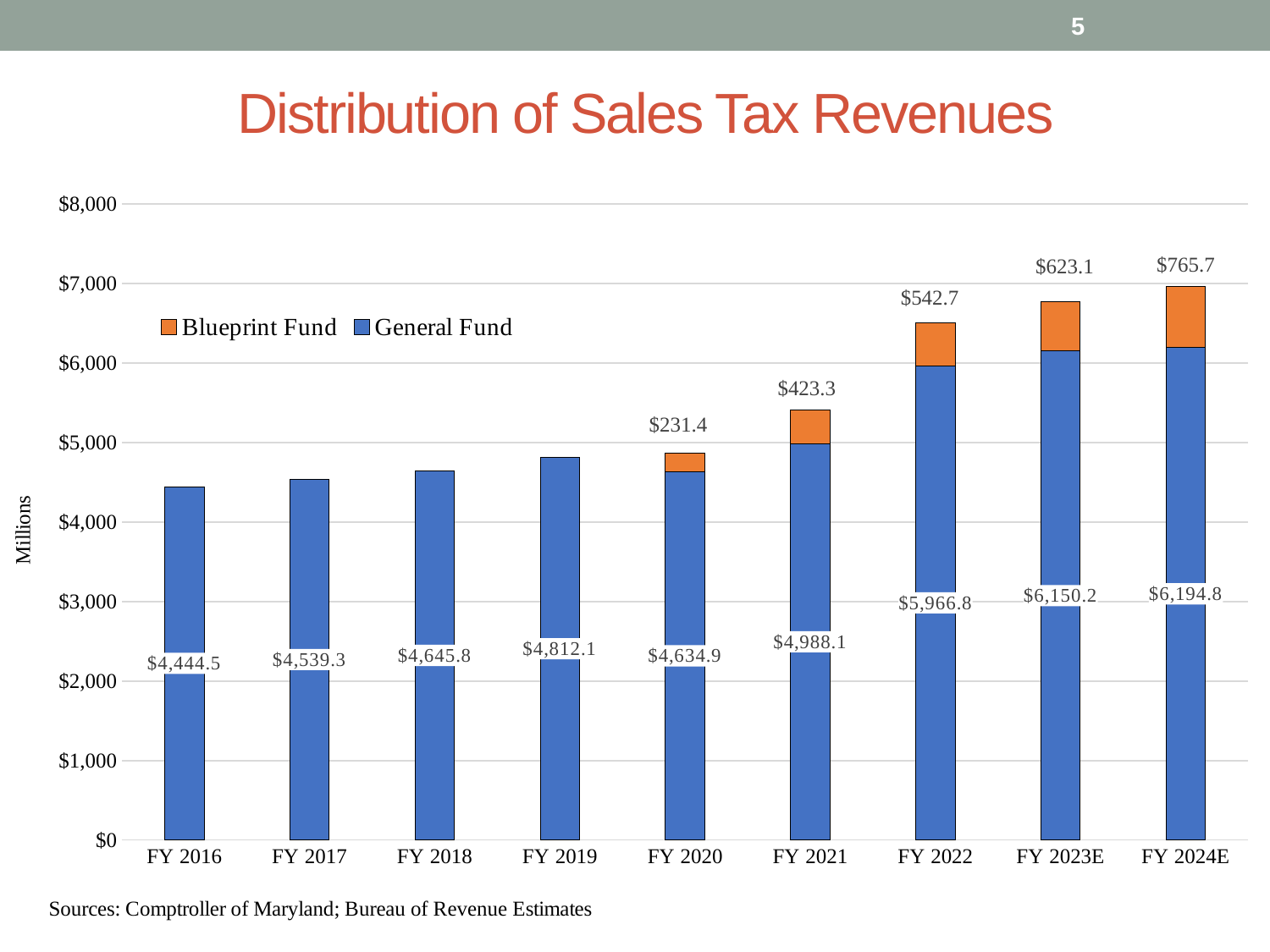
How many series does the legend list? 2 Which fiscal year has the lowest General Fund value? FY 2016 How many fiscal years are shown on the x axis? 9 Which is larger, the General Fund value for FY 2019 or for FY 2020? FY 2019 What is the General Fund value for FY 2023E? $6,150.2 What is the total of the stacked bar for FY 2022? $6,509.5 What is the General Fund value for FY 2016? $4,444.5 Which fiscal year has the highest General Fund value? FY 2024E What is the difference between the Blueprint Fund values for FY 2024E and FY 2020? $534.3 What is the total of the stacked bar for FY 2024E? $6,960.5 What is the Blueprint Fund value for FY 2021? $423.3 What kind of chart is shown on the slide? Stacked bar chart